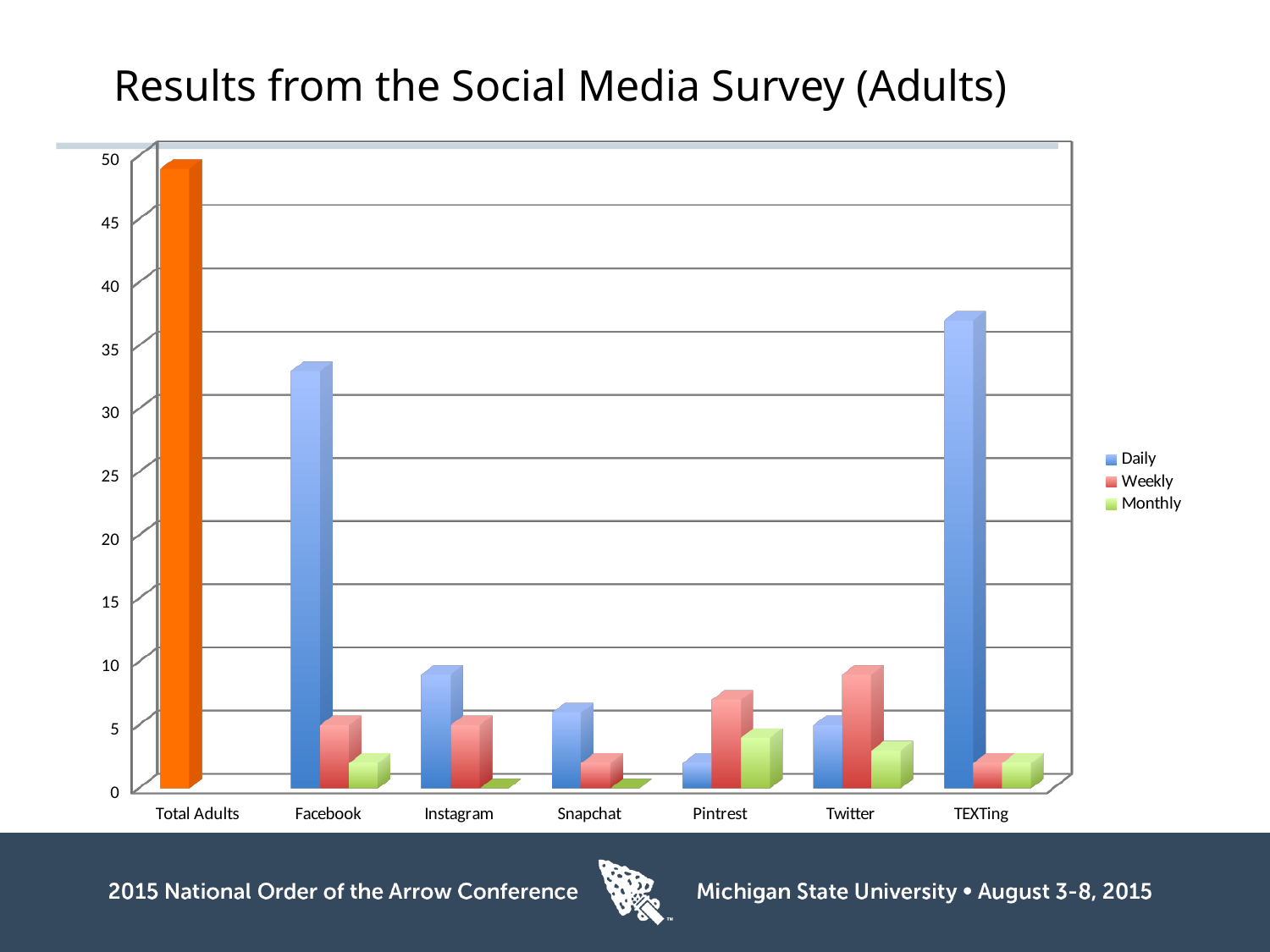
Which is larger, the Daily value for Facebook or the Daily value for TEXTing? TEXTing What kind of chart is shown on the slide? bar chart Is the Daily value for Instagram greater or less than 15? less Which category has the highest Daily bar among the social media platforms (excluding Total Adults)? TEXTing Is the Total Adults value greater or less than 45? greater For Twitter, which is larger, the Daily value or the Weekly value? Weekly How many series does the legend list? 3 Which series is shown in green in the legend? Monthly Is the Daily value for Facebook greater or less than 30? greater How many categories are shown along the x axis? 7 Which category has the lowest Daily bar? Pintrest What is the title of the chart on the slide? Results from the Social Media Survey (Adults)